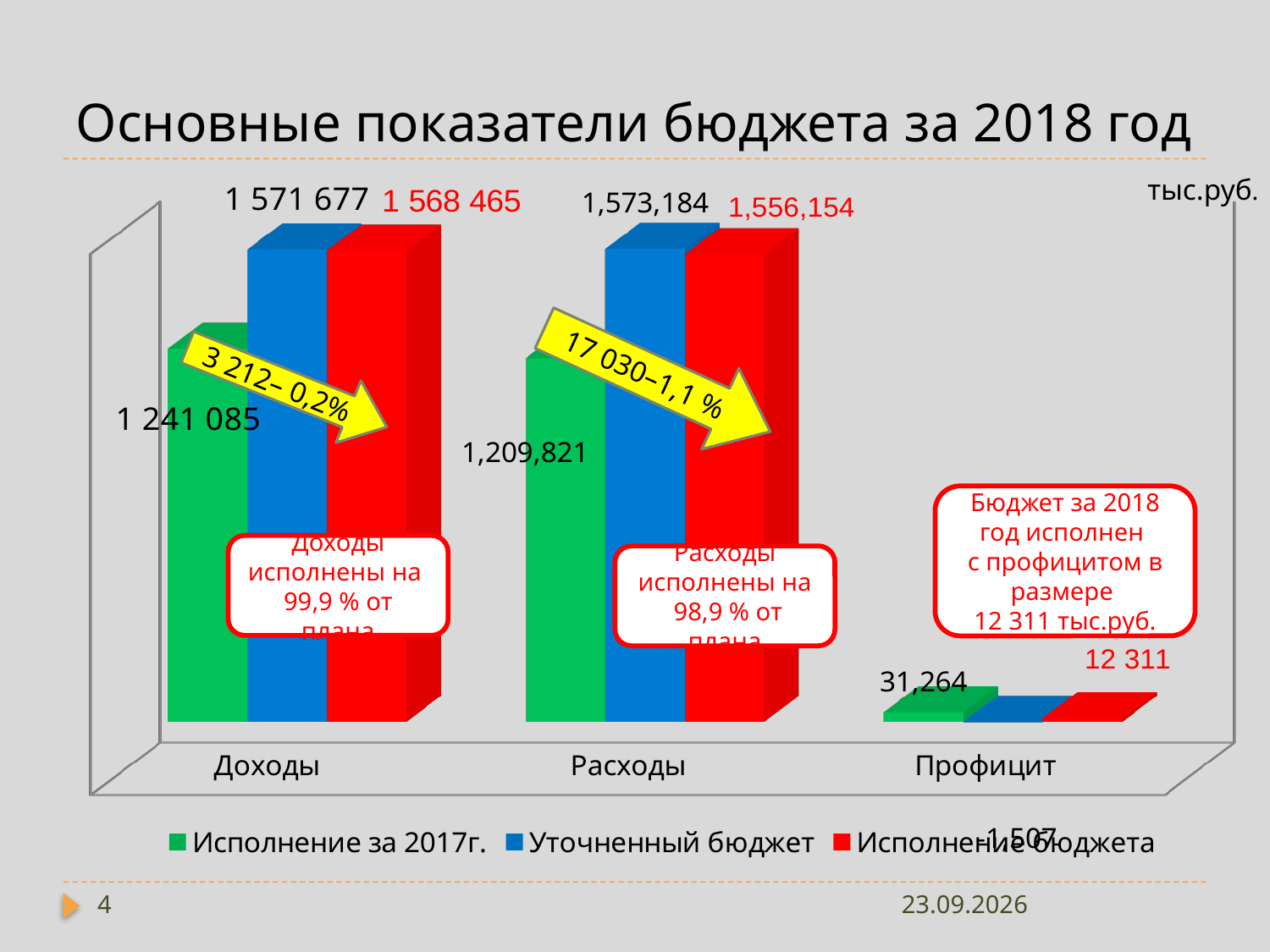
How many series does the legend list? 3 What is the value of Уточненный бюджет for Доходы? 1 571 677 How many categories are shown on the x axis? 3 Which is larger for Исполнение за 2017г.: Доходы or Расходы? Доходы Which series has the highest value in the Доходы category? Уточненный бюджет What type of chart is shown on the slide? Bar chart What is the value of Исполнение за 2017г. for Профицит? 31,264 What is the value of Исполнение за 2017г. for Доходы? 1 241 085 Which category has the lowest value for the Исполнение бюджета series? Профицит What is the difference between Уточненный бюджет and Исполнение бюджета for Доходы? 3 212 What is the value of Исполнение бюджета for Расходы? 1,556,154 What is the value of Исполнение бюджета for Профицит? 12 311